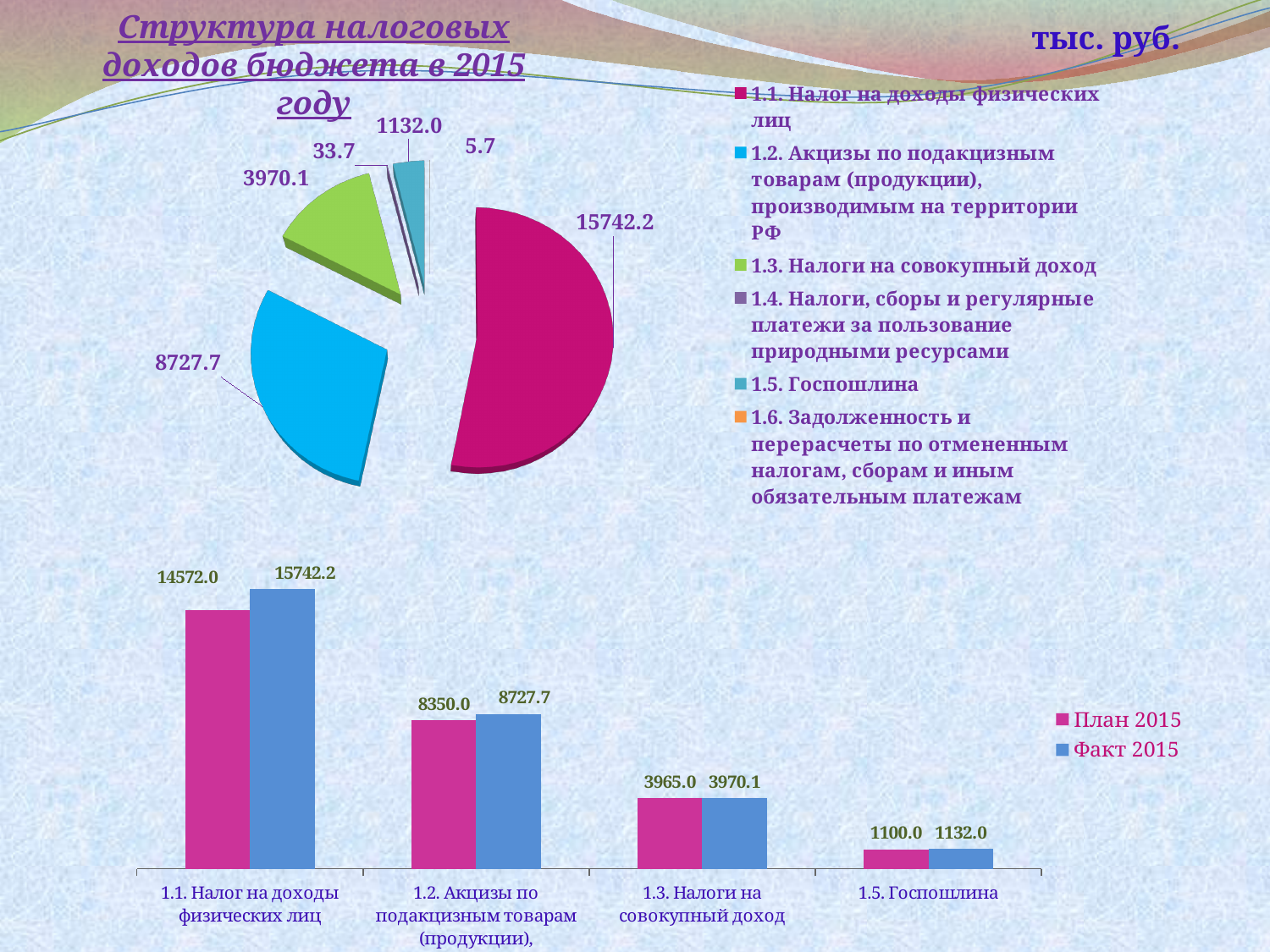
On the pie chart, what is the difference between the values for 1.2. Акцизы по подакцизным товарам and 1.3. Налоги на совокупный доход? 4757.6 How many categories does the legend of the pie chart list? 6 On the bottom bar chart, how many categories are shown on the x axis? 4 On the bottom bar chart, how much larger is Факт 2015 than План 2015 for 1.1. Налог на доходы физических лиц? 1170.2 On the pie chart, what is the value for 1.5. Госпошлина? 1132.0 On the pie chart, which category has the smallest value? 1.6. Задолженность и перерасчеты по отмененным налогам, сборам и иным обязательным платежам On the pie chart, which category has the largest value? 1.1. Налог на доходы физических лиц On the bottom bar chart, what is the Факт 2015 value for 1.5. Госпошлина? 1132.0 What type of chart is the bottom chart on the slide? bar chart On the bottom bar chart, which series does the legend list first? План 2015 On the bottom bar chart, what is the План 2015 value for 1.2. Акцизы по подакцизным товарам (продукции)? 8350.0 On the pie chart, what is the value for 1.1. Налог на доходы физических лиц? 15742.2